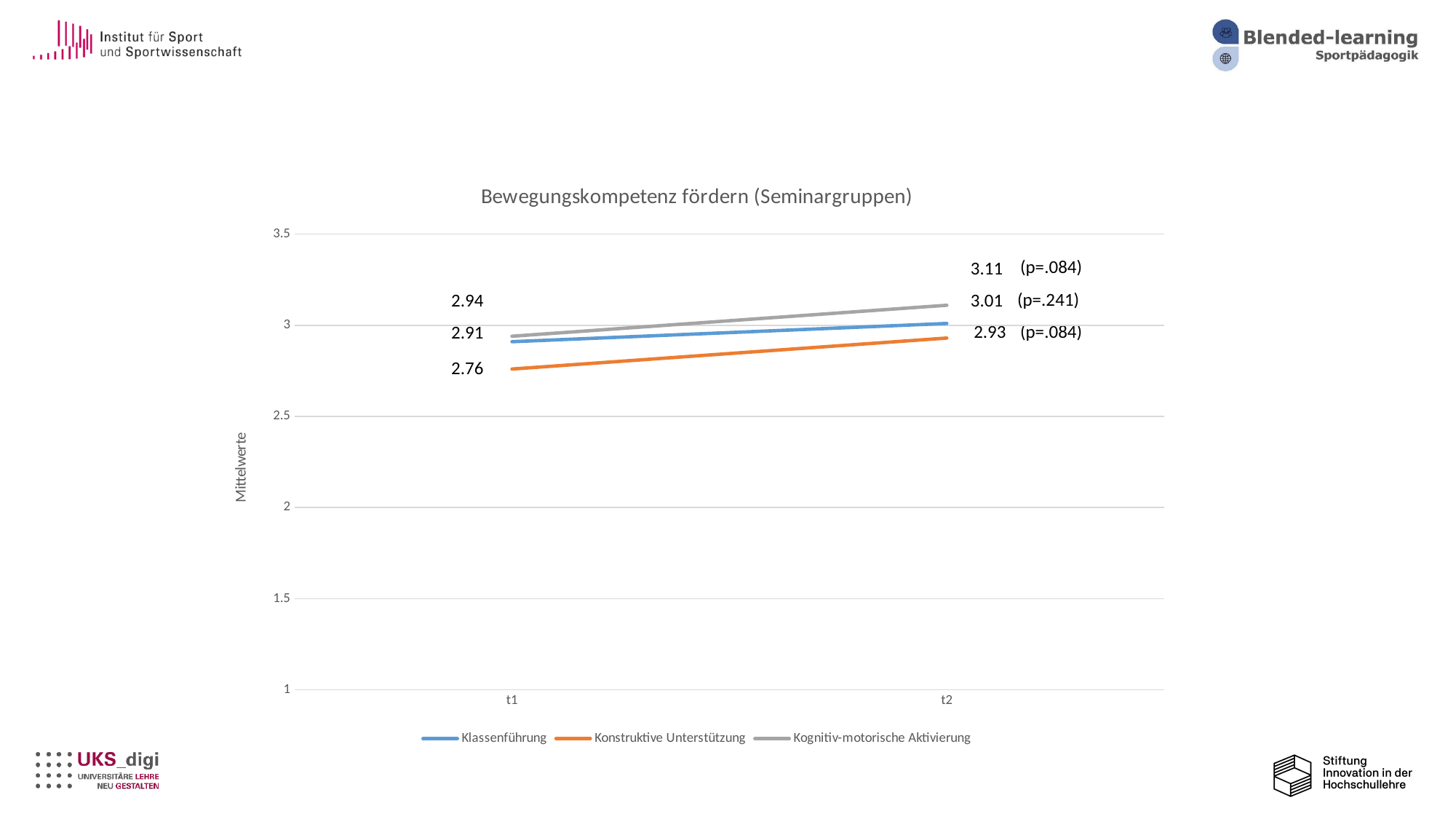
Which is larger at t2: the value for Klassenführung or the value for Konstruktive Unterstützung? Klassenführung Which series has the lowest value at t1? Konstruktive Unterstützung Do the values for Klassenführung rise or fall from t1 to t2? rise How many time points are shown on the x axis? 2 How many series does the legend list? 3 What is the value for Klassenführung at t2? 3.01 What is the value for Kognitiv-motorische Aktivierung at t2? 3.11 What kind of chart is shown on the slide? line chart What is the value for Konstruktive Unterstützung at t1? 2.76 By how much does the value for Konstruktive Unterstützung change from t1 to t2? 0.17 What is the title of the chart? Bewegungskompetenz fördern (Seminargruppen) Which series has the highest value at t2? Kognitiv-motorische Aktivierung